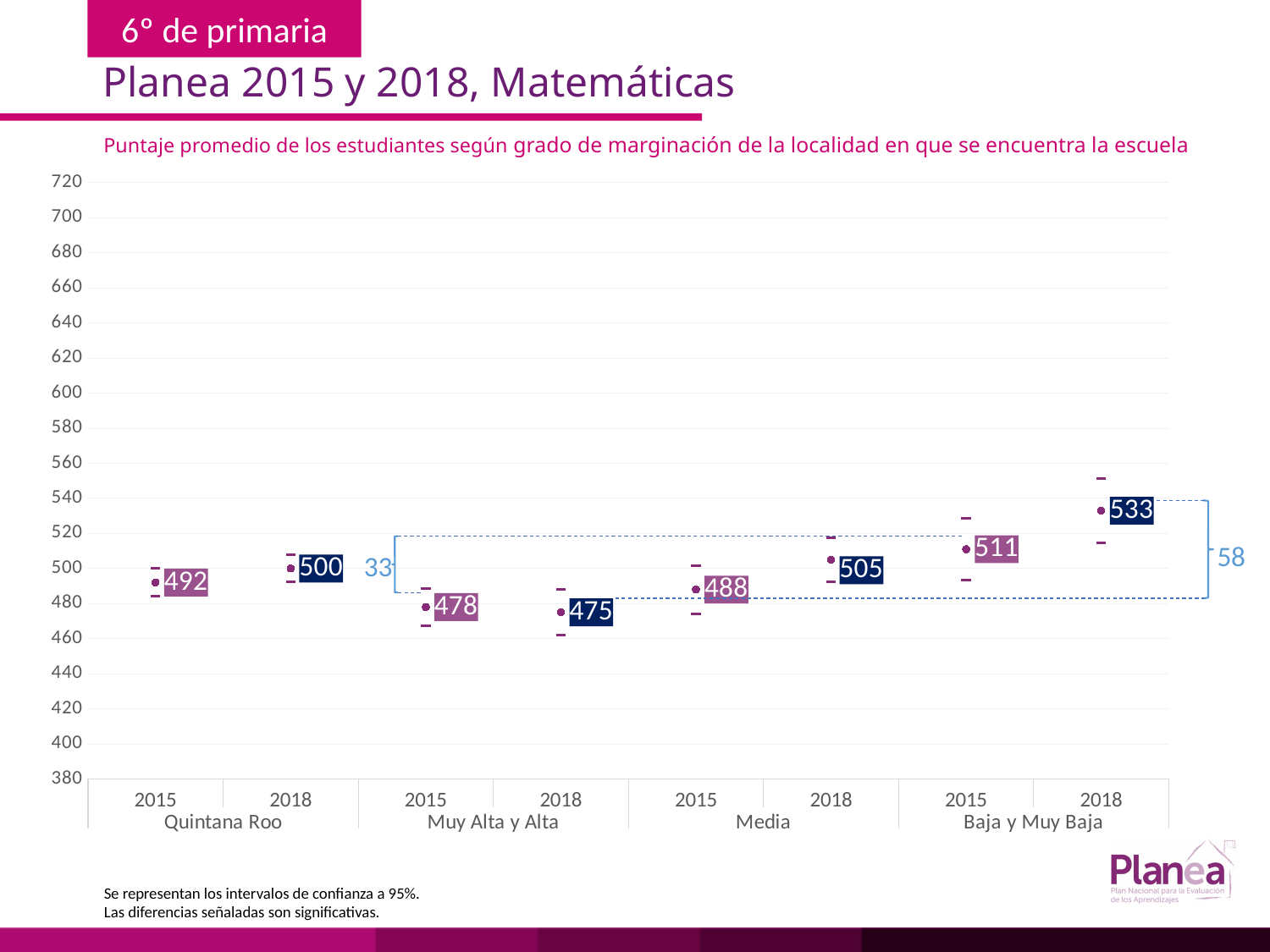
What is the average score for Media in 2015? 488 What is the difference between the 2018 and 2015 scores for Media? 17 How many data points are plotted on the chart? 8 Which group and year has the highest average score? Baja y Muy Baja, 2018 Which group and year has the lowest average score? Muy Alta y Alta, 2018 Which is larger, the 2015 score for Muy Alta y Alta or the 2015 score for Media? Media (488) What is the difference between the 2018 and 2015 scores for Baja y Muy Baja? 22 What is the average score for Baja y Muy Baja in 2018? 533 What is the subtitle of the chart? Puntaje promedio de los estudiantes según grado de marginación de la localidad en que se encuentra la escuela What is the average score for Quintana Roo in 2018? 500 What is the average score for Quintana Roo in 2015? 492 What is the average score for Muy Alta y Alta in 2018? 475